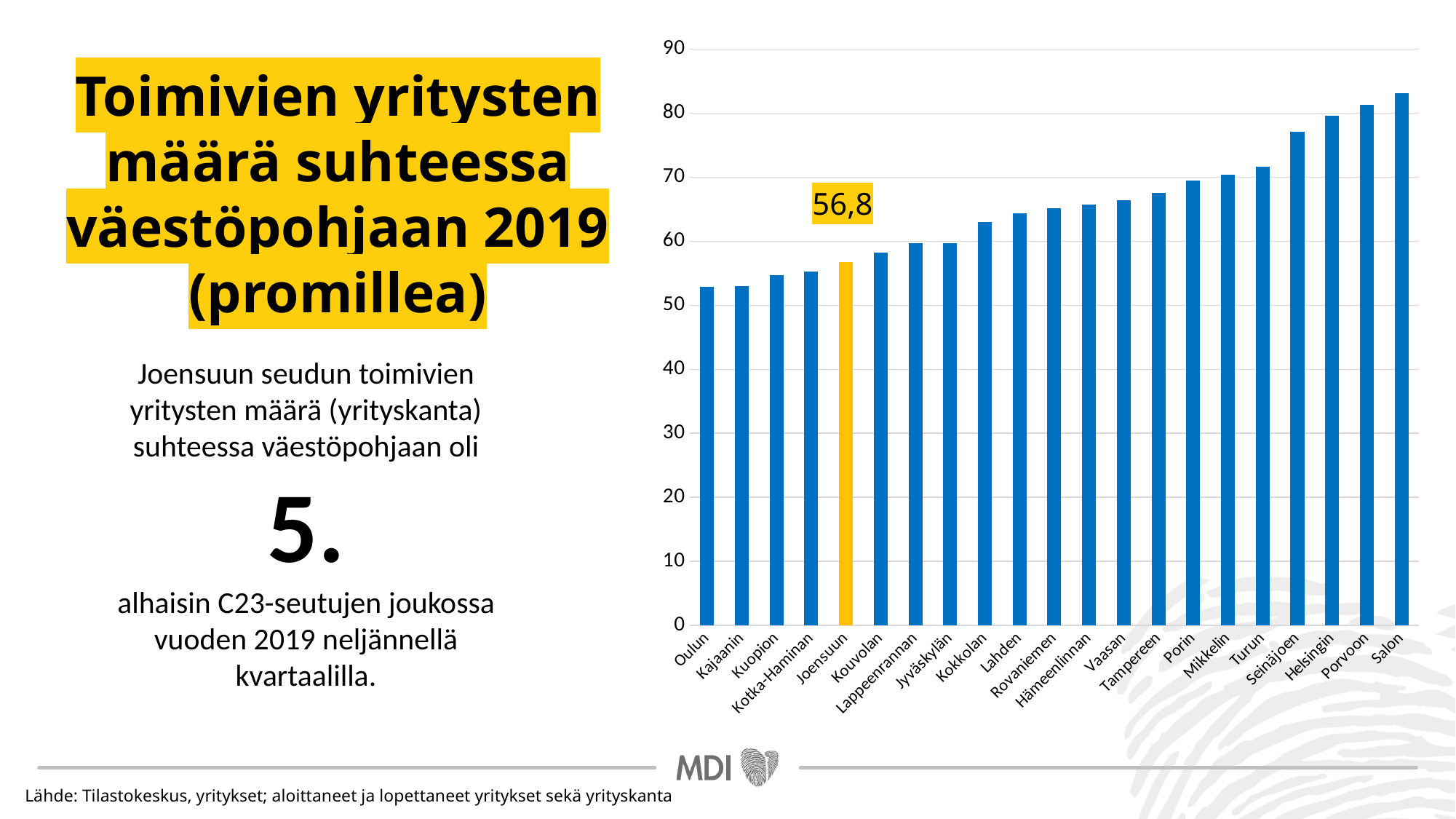
Which is larger, the value for Salon or the value for Oulun? Salon Which bar is highlighted in a different colour (yellow) from the others? Joensuun How many regions are shown on the x axis of the chart? 21 Is the value for Seinäjoen greater or less than 70? greater Is the value for Salon greater or less than 80? greater Do the bar values rise or fall from left to right along the x axis? Rise What value is labelled on the bar for Joensuun? 56,8 Is the value for Kouvolan greater or less than 60? less Which region has the highest bar in the chart? Salon Which is larger, the value for Seinäjoen or the value for Vaasan? Seinäjoen What kind of chart is shown on the slide? Bar chart